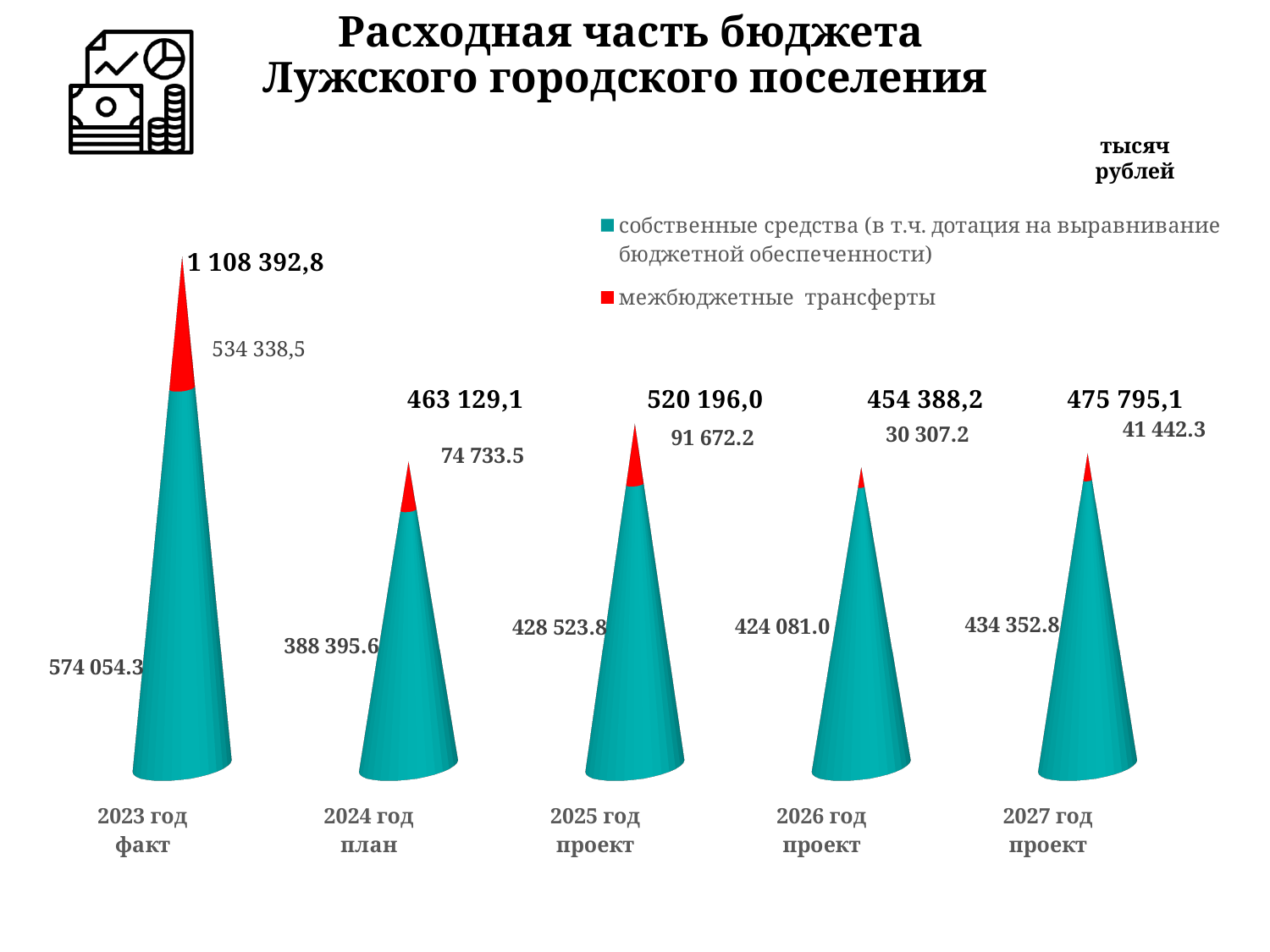
Which year has the highest total budget expenditure? 2023 год факт What is the difference between собственные средства for 2025 год проект and 2024 год план? 40 128.2 How many series does the legend list? 2 How many years (categories) are shown on the chart? 5 What is the value of собственные средства for 2027 год проект? 434 352.8 What is the value of собственные средства for 2023 год факт? 574 054.3 What is the total of the stacked bar for 2025 год проект? 520 196,0 Which is larger: the total for 2026 год проект or the total for 2027 год проект? 2027 год проект Which year has the lowest value of межбюджетные трансферты? 2026 год проект What is the value of межбюджетные трансферты for 2024 год план? 74 733.5 What is the difference between межбюджетные трансферты for 2025 год проект and 2026 год проект? 61 365.0 What colour represents межбюджетные трансферты in the chart? Red